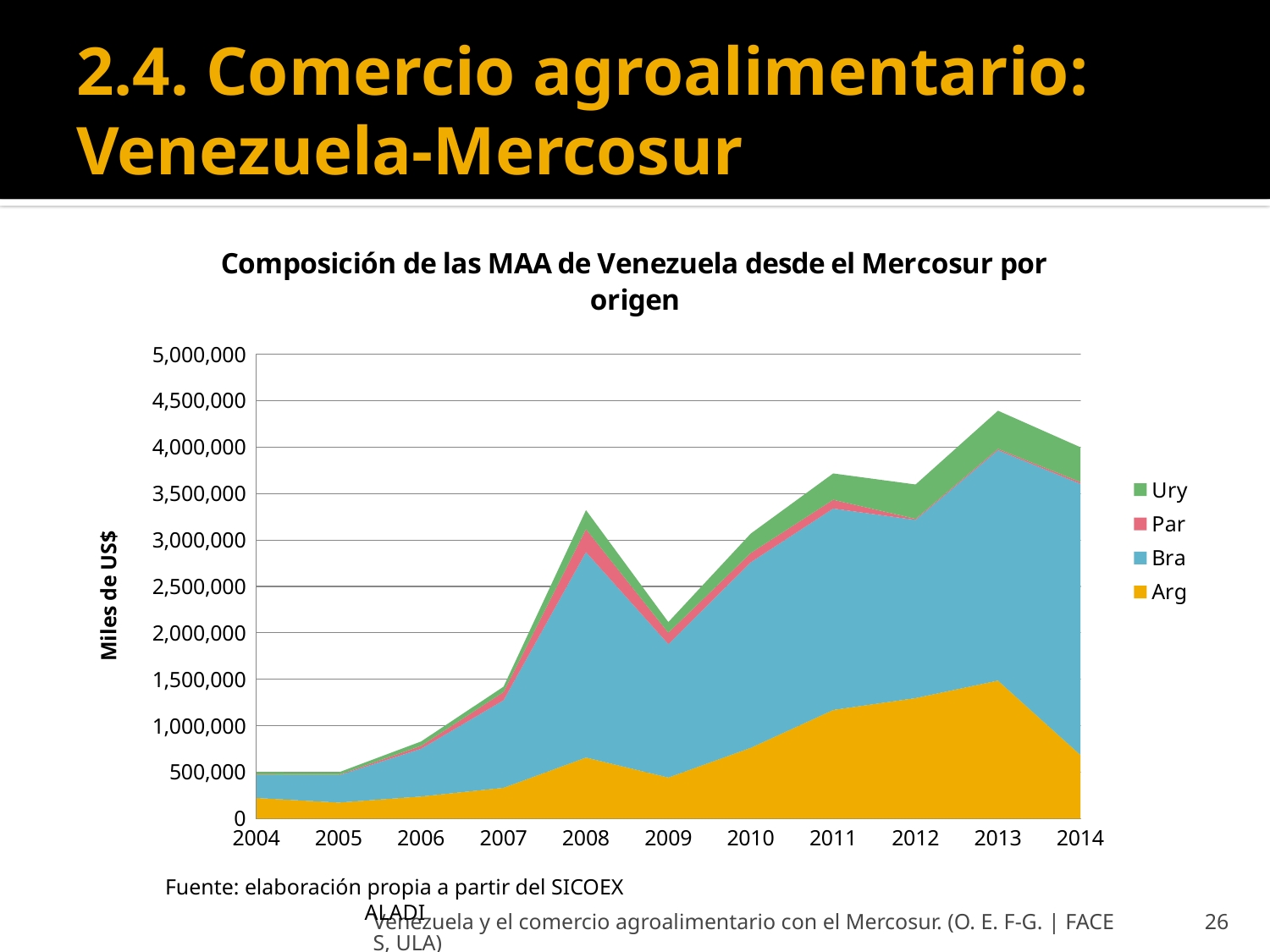
What kind of chart is shown on the slide? Stacked area chart Is the total value for 2013 greater or less than 4,000,000? greater Is the total value for 2009 greater or less than 2,500,000? less Is the total value for 2004 greater or less than 1,000,000? less Which is larger, the value for Arg in 2013 or the value for Arg in 2014? Arg in 2013 What is the title of the y axis? Miles de US$ Which series contributes the most to the total in 2014? Bra How many years are shown along the x axis? 11 Does the total rise or fall from 2008 to 2009? Fall How many series does the legend list? 4 In which year is the total of all series highest? 2013